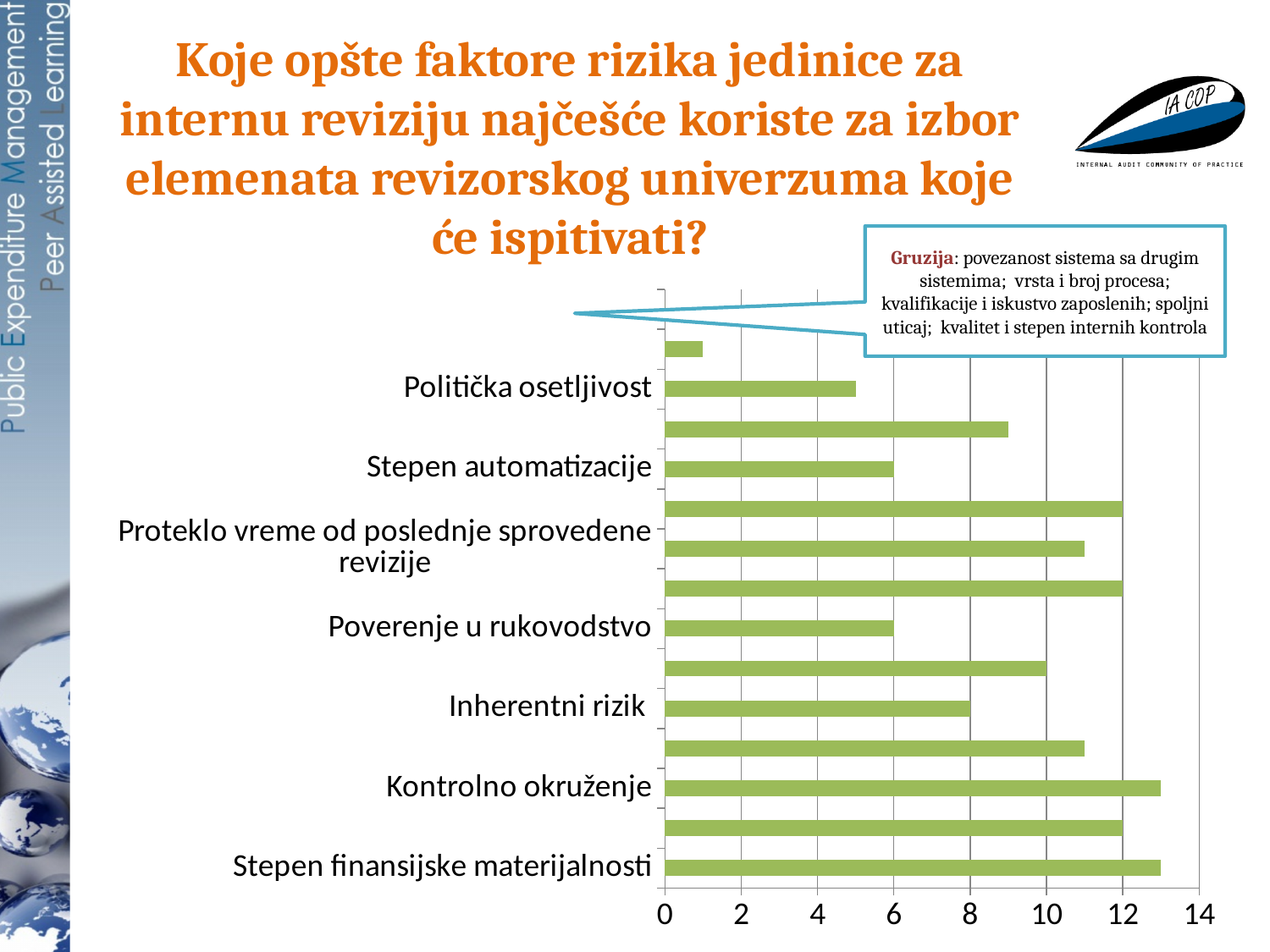
Is the value for Kontrolno okruženje greater or less than 12? greater Is the value for Proteklo vreme od poslednje sprovedene revizije greater or less than 10? greater Which is larger, the value for Kontrolno okruženje or the value for Politička osetljivost? Kontrolno okruženje What is the highest value shown on the horizontal axis? 14 How many bars are plotted in the chart? 14 Is the value for Politička osetljivost greater or less than 6? less What is the value for Stepen automatizacije? 6 Which is larger, the value for Inherentni rizik or the value for Stepen automatizacije? Inherentni rizik What is the value for Inherentni rizik? 8 What is the value for Poverenje u rukovodstvo? 6 What kind of chart is shown on the slide? bar chart